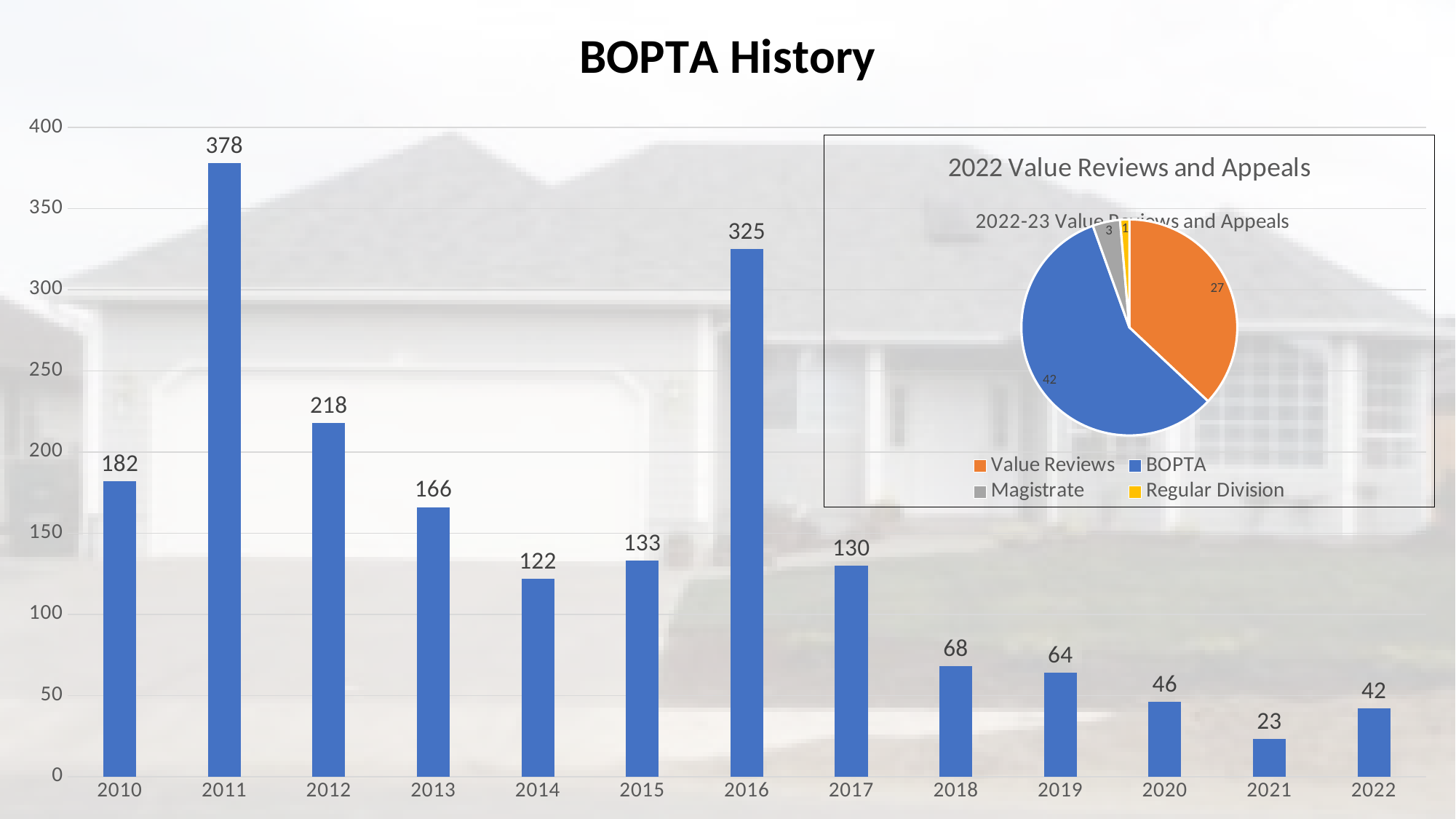
In the BOPTA History bar chart, which is larger, the value for 2014 or the value for 2015? 2015 In the BOPTA History bar chart, what is the value for 2016? 325 In the BOPTA History bar chart, what is the value for 2011? 378 In the 2022 Value Reviews and Appeals pie chart, how many categories does the legend list? 4 In the BOPTA History bar chart, what is the difference between the values for 2012 and 2013? 52 In the BOPTA History bar chart, how many years are shown on the x axis? 13 In the 2022 Value Reviews and Appeals pie chart, what is the value for BOPTA? 42 In the BOPTA History bar chart, which year has the highest value? 2011 In the 2022 Value Reviews and Appeals pie chart, which category has the smallest slice? Regular Division In the BOPTA History bar chart, which year has the lowest value? 2021 In the BOPTA History bar chart, do the values generally rise or fall from 2016 to 2021? Fall What kind of chart is the BOPTA History chart? Bar chart